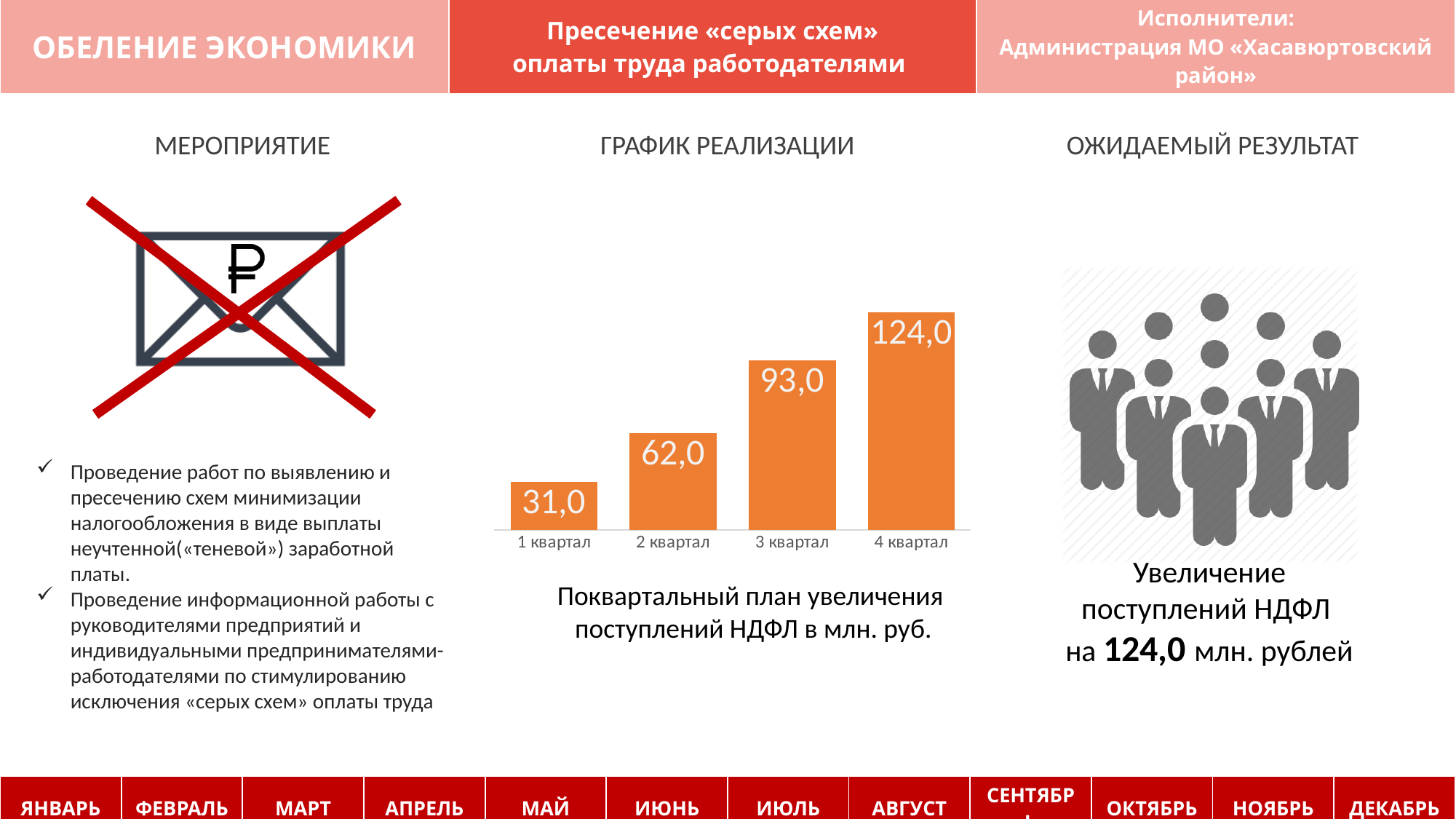
What is the value for 4 квартал? 124,0 Do the values rise or fall from 1 квартал to 4 квартал? rise Which is larger, the value for 2 квартал or the value for 3 квартал? 3 квартал What is the difference between the values for 4 квартал and 3 квартал? 31,0 What is the value for 3 квартал? 93,0 What is the value for 2 квартал? 62,0 Which quarter has the highest value? 4 квартал How many categories are shown on the chart? 4 What kind of chart is shown on the slide? bar chart What is the difference between the values for 2 квартал and 1 квартал? 31,0 Which quarter has the lowest value? 1 квартал What is the value for 1 квартал? 31,0